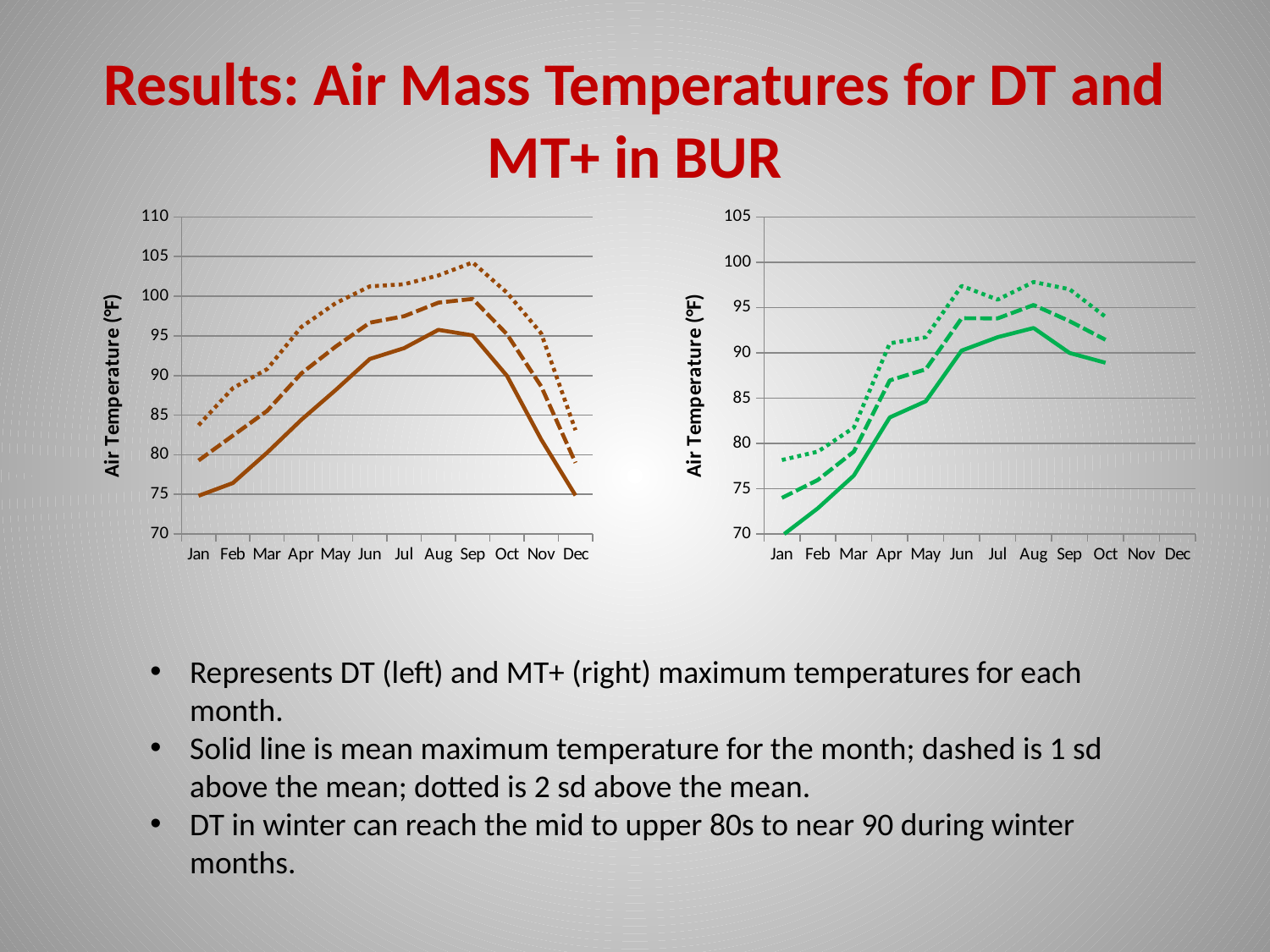
On the left chart (DT), is the solid line's value for Jun greater or less than 90? greater What kind of chart is the left chart (DT)? line chart What is the y-axis title on the left chart (DT)? Air Temperature (°F) On the left chart (DT), is the dotted line's value for Jan greater or less than 85? less How many month categories are labelled on the x axis of the left chart (DT)? 12 On the right chart (MT+), does the solid line rise or fall from Jan to Aug? rise On the left chart (DT), in which month does the dotted line reach its highest value? Sep On the left chart (DT), which is larger for the solid line: the value for Aug or the value for Jan? Aug On the right chart (MT+), is the dotted line's value for Aug greater or less than 95? greater How many lines are plotted on the right chart (MT+)? 3